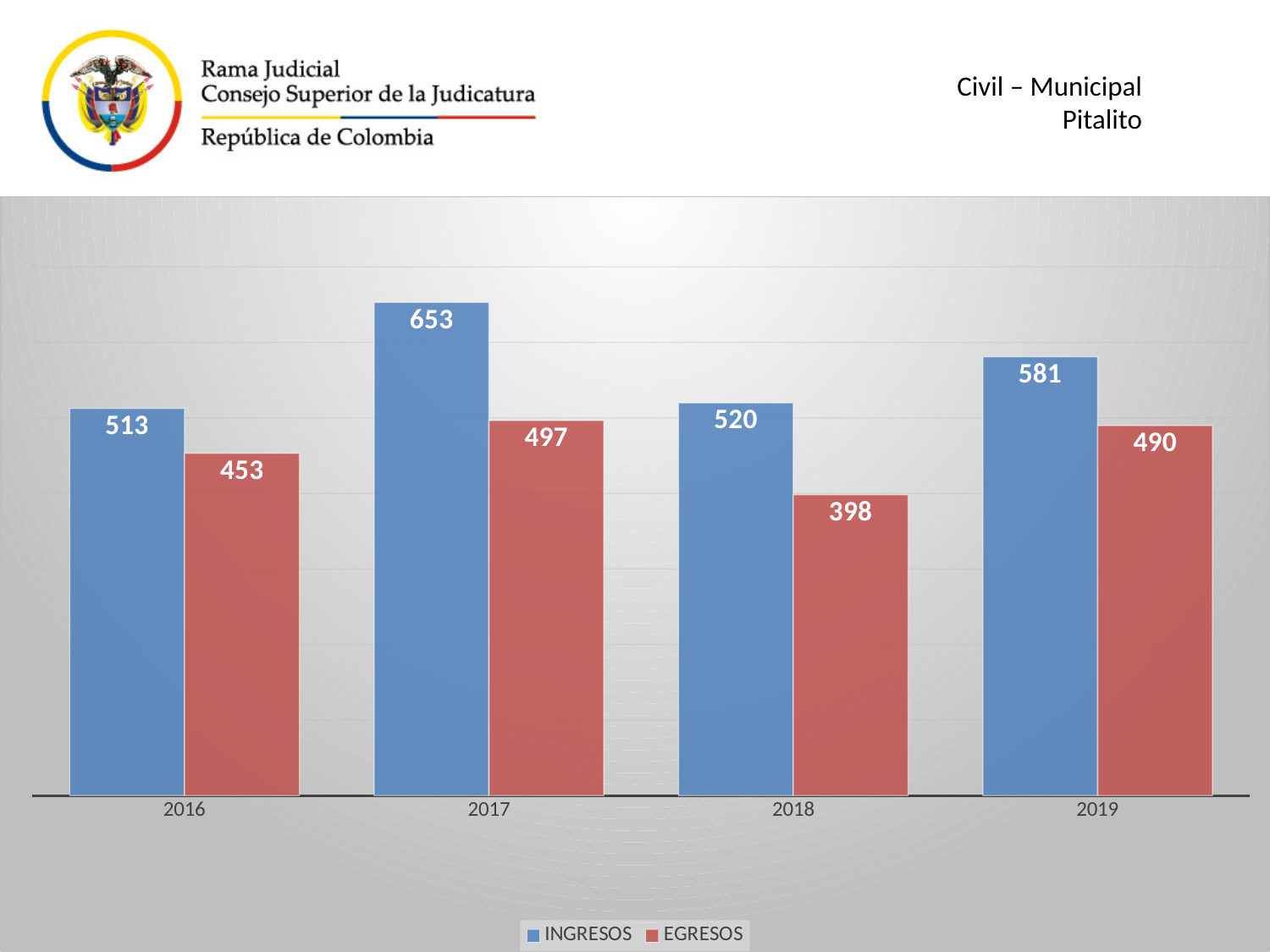
Which colour represents the EGRESOS series? Red What is the INGRESOS value for 2017? 653 Which year has the highest INGRESOS value? 2017 What is the difference between INGRESOS in 2017 and INGRESOS in 2016? 140 How many years are shown on the x axis? 4 What is the difference between INGRESOS and EGRESOS in 2018? 122 Which year has the lowest EGRESOS value? 2018 Which is larger, EGRESOS in 2017 or EGRESOS in 2019? EGRESOS in 2017 What is the EGRESOS value for 2018? 398 What is the EGRESOS value for 2016? 453 What kind of chart is shown on the slide? Bar chart How many series does the legend list? 2